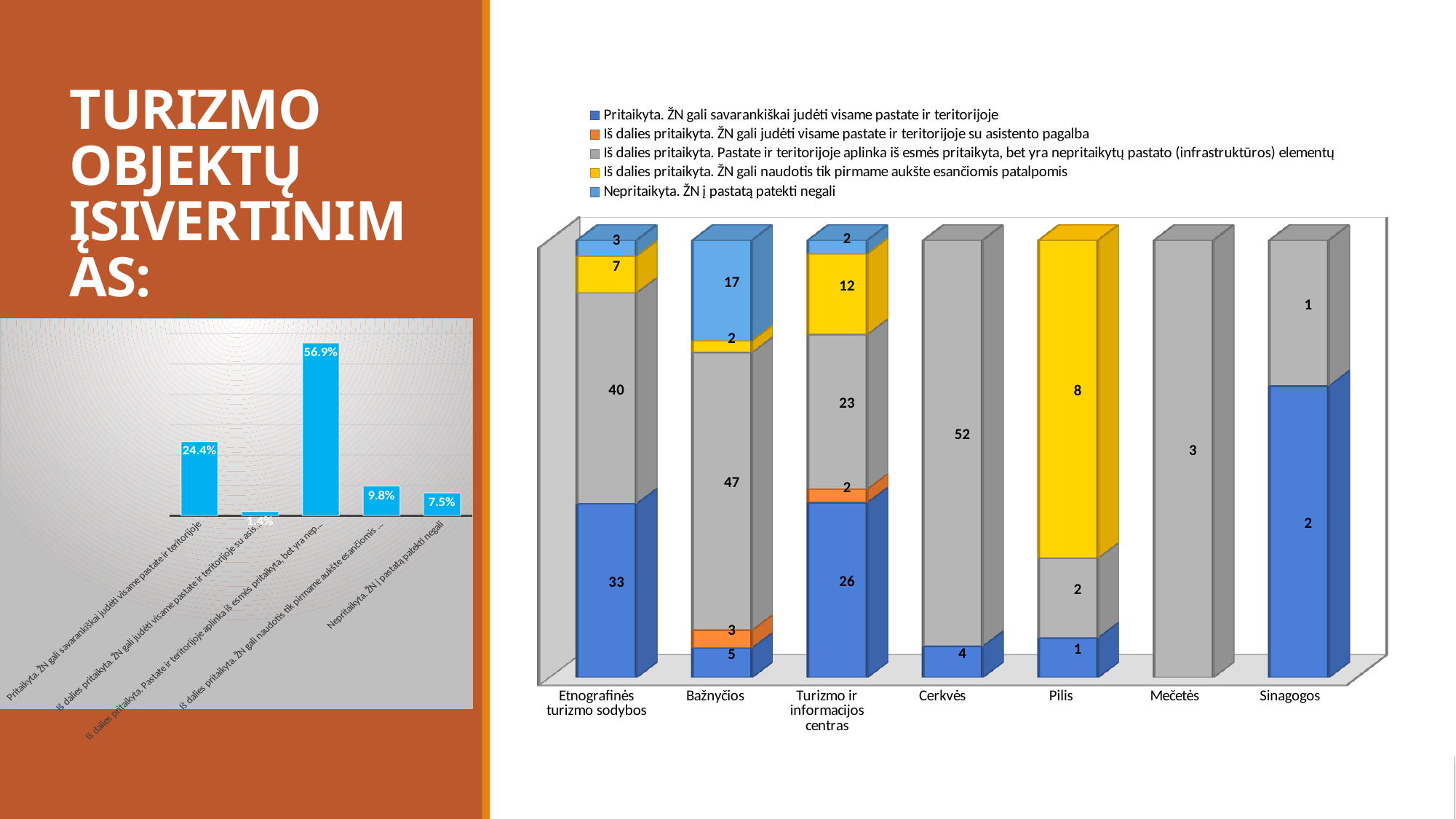
On the right stacked bar chart, what is the difference between the gray segment values for Cerkvės and Etnografinės turizmo sodybos? 12 On the right stacked bar chart, what is the value of the 'Pritaikyta. ŽN gali savarankiškai judėti visame pastate ir teritorijoje' series for Etnografinės turizmo sodybos? 33 On the left bar chart, what is the value for 'Nepritaikyta. ŽN į pastatą patekti negali'? 7.5% On the right stacked bar chart, what is the total of the stacked bar for Cerkvės? 56 On the right stacked bar chart, what is the value of the 'Iš dalies pritaikyta. ŽN gali naudotis tik pirmame aukšte esančiomis patalpomis' series for Pilis? 8 On the right stacked bar chart, how many series does the legend list? 5 On the right stacked bar chart, what is the value of the 'Nepritaikyta. ŽN į pastatą patekti negali' series for Bažnyčios? 17 What kind of chart is the chart on the right of the slide? Stacked bar chart On the right stacked bar chart, what is the total of the stacked bar for Turizmo ir informacijos centras? 65 On the left bar chart, which category has the highest value? Iš dalies pritaikyta. Pastate ir teritorijoje aplinka iš esmės pritaikyta, bet yra nep... On the right stacked bar chart, how many categories are shown on the x axis? 7